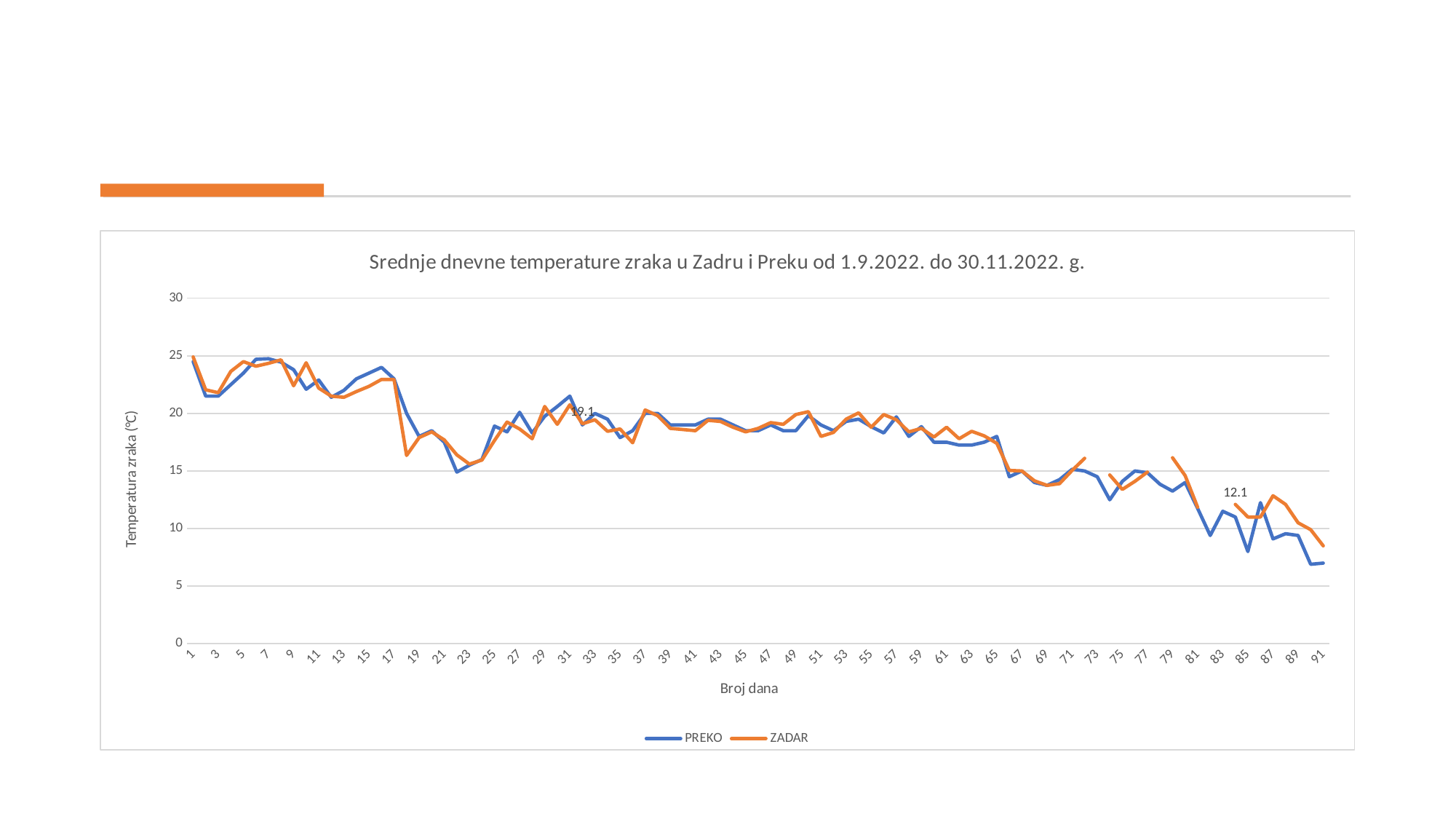
What are the two series named in the legend? PREKO and ZADAR What is the title of the vertical axis? Temperatura zraka (°C) Over the whole period from day 1 to day 91, do the temperatures generally rise or fall? fall What is the data label printed on the chart near day 32? 19.1 Is the ZADAR value at day 18 greater or less than 20? less At day 85, which series has the higher value, PREKO or ZADAR? ZADAR Is the PREKO value at day 91 greater or less than 10? less What kind of chart is shown on the slide? line chart How many series does the legend list? 2 What is the data label printed on the chart near day 83? 12.1 At day 18, which series has the higher value, PREKO or ZADAR? PREKO Is the ZADAR value at day 1 greater or less than 20? greater